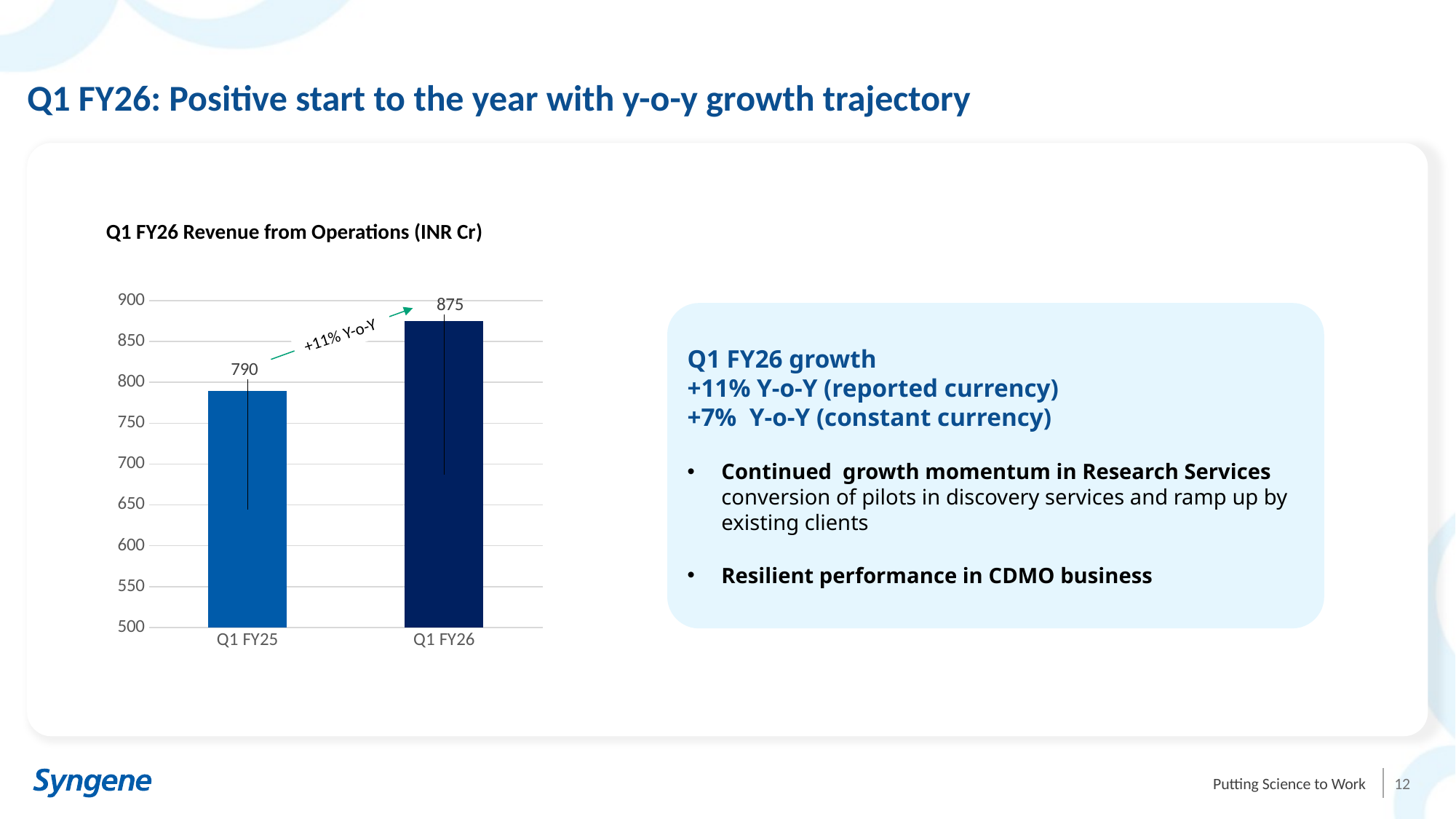
Which quarter has the lower revenue from operations? Q1 FY25 What year-on-year growth percentage is annotated on the chart between the two bars? +11% Y-o-Y What is the title of the chart? Q1 FY26 Revenue from Operations (INR Cr) Is the revenue for Q1 FY26 greater or less than 850? greater How many categories are shown on the x axis of the chart? 2 Is the revenue for Q1 FY25 greater or less than 800? less What kind of chart is shown on the slide? Bar chart What is the revenue from operations for Q1 FY25? 790 Do the values rise or fall from Q1 FY25 to Q1 FY26? Rise Which quarter has the higher revenue from operations? Q1 FY26 What is the difference in revenue from operations between Q1 FY26 and Q1 FY25? 85 What is the revenue from operations for Q1 FY26? 875